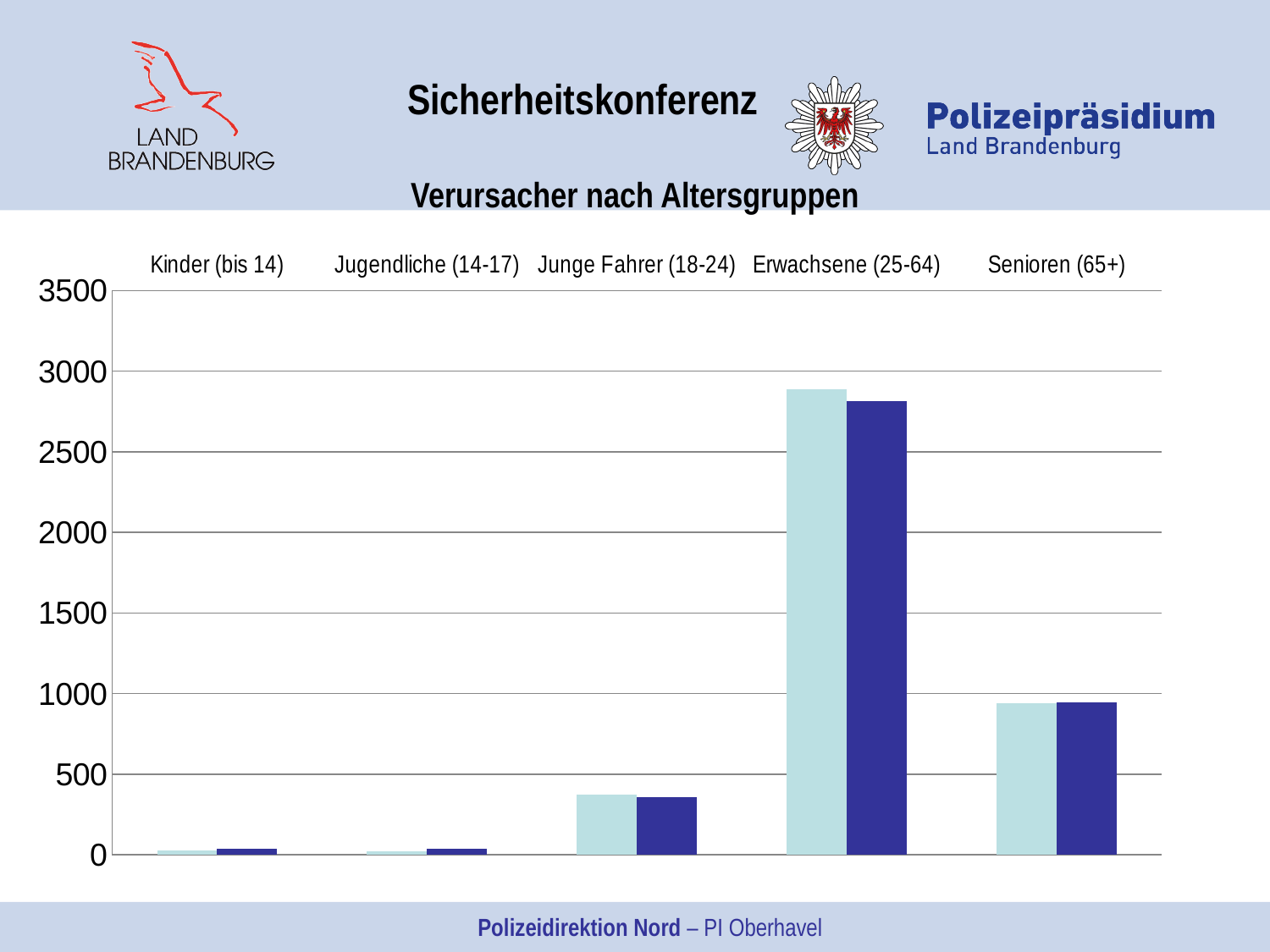
Which age group has the highest bars in the chart? Erwachsene (25-64) How many bars are shown for each age group in the chart? 2 Which has the larger light blue bar, Erwachsene (25-64) or Senioren (65+)? Erwachsene (25-64) What kind of chart is shown on the slide? bar chart How many age groups are shown on the x axis of the chart? 5 Is the value of the light blue bar for Kinder (bis 14) greater or less than 500? less Is the value of the dark blue bar for Erwachsene (25-64) greater or less than 3000? less Is the value of the light blue bar for Senioren (65+) greater or less than 1000? less What is the title of the chart? Verursacher nach Altersgruppen Which has the larger dark blue bar, Junge Fahrer (18-24) or Senioren (65+)? Senioren (65+)